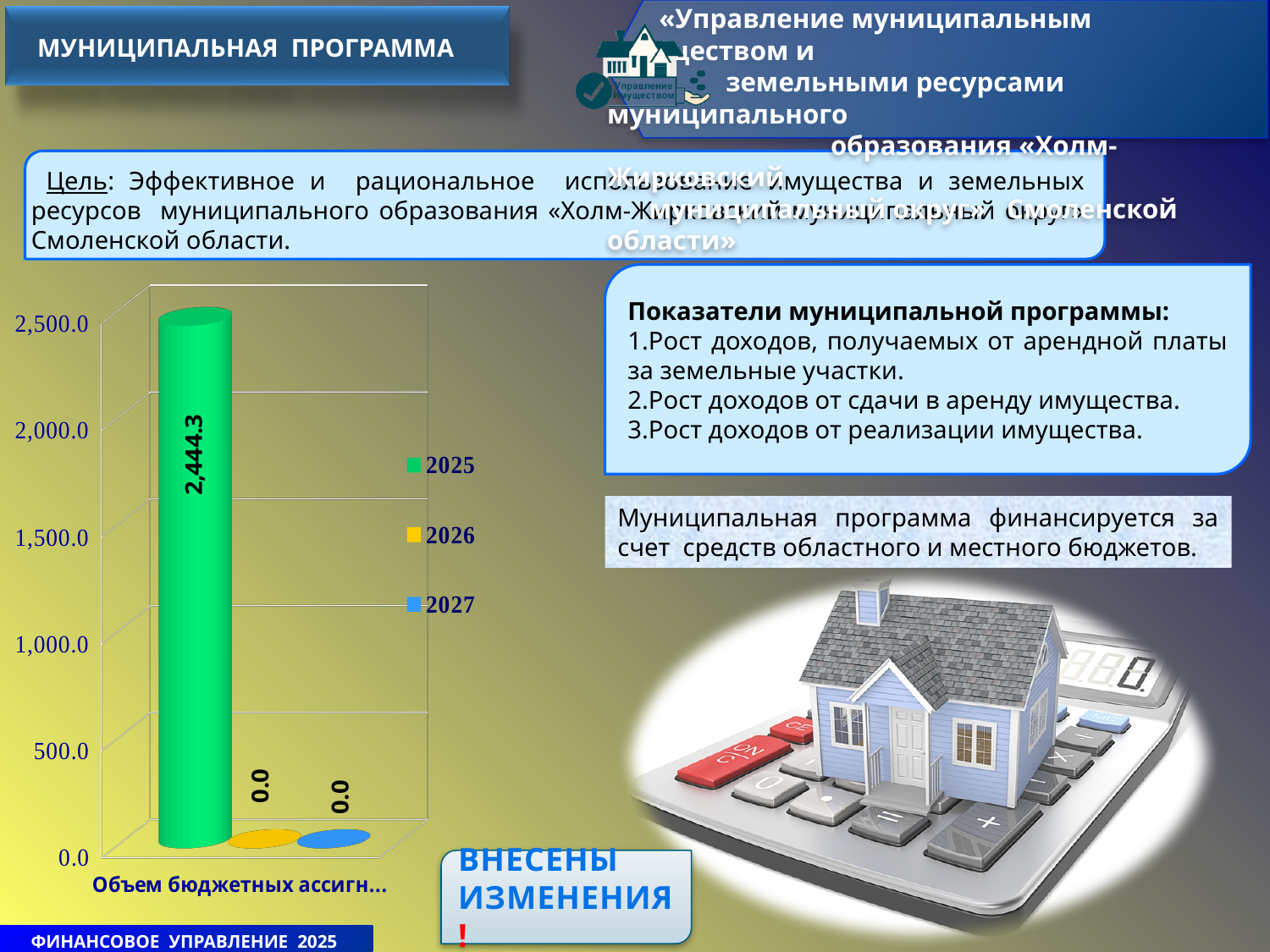
What colour is the bar for the 2025 series? green How many series does the legend list? 3 What is the difference between the 2025 value and the 2026 value? 2,444.3 Which series has the highest value on the chart? 2025 What is the value for the 2025 series on the chart? 2,444.3 What is the value for the 2026 series on the chart? 0.0 Is the value for 2025 greater or less than 2,500.0? less What is the highest value shown on the vertical axis of the chart? 2,500.0 What is the value for the 2027 series on the chart? 0.0 Is the value for 2025 greater or less than 2,000.0? greater Which is larger, the value for 2025 or the value for 2027? 2025 What kind of chart is shown on the slide? bar chart